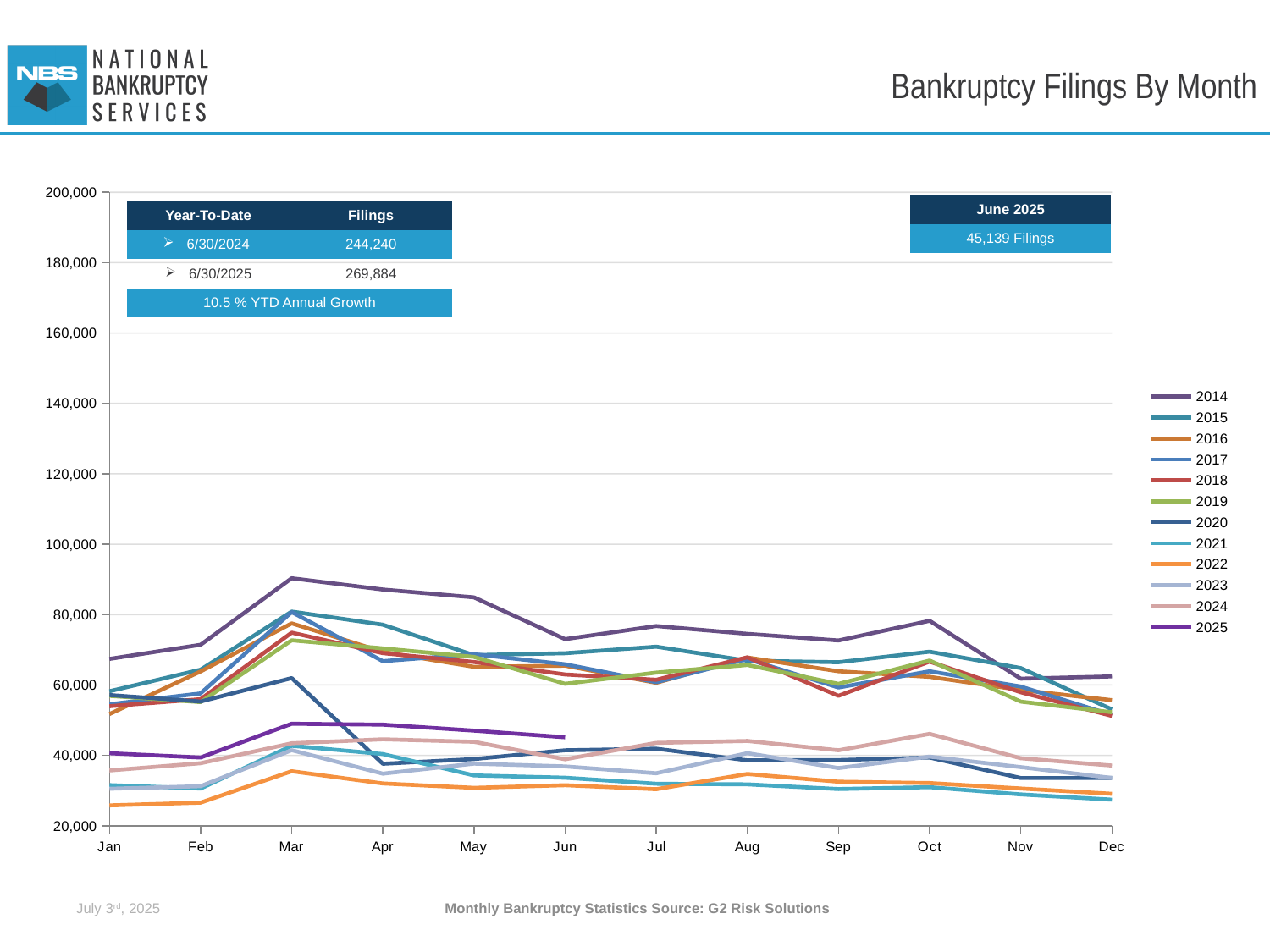
How many months are shown along the x axis? 12 Which year has the highest value in Mar? 2014 Is the value for 2014 in Mar greater or less than 80,000? greater What is the year-to-date filings figure for 6/30/2025? 269,884 Does the 2014 line rise or fall from Mar to Jun? fall How many series does the legend list? 12 How many filings were there in June 2025? 45,139 Which is larger in Oct, the value for 2014 or the value for 2015? 2014 Which year has the lowest value in Jan? 2022 What is the year-to-date filings figure for 6/30/2024? 244,240 Is the value for 2022 in Jan greater or less than 40,000? less What kind of chart is shown on the slide? line chart